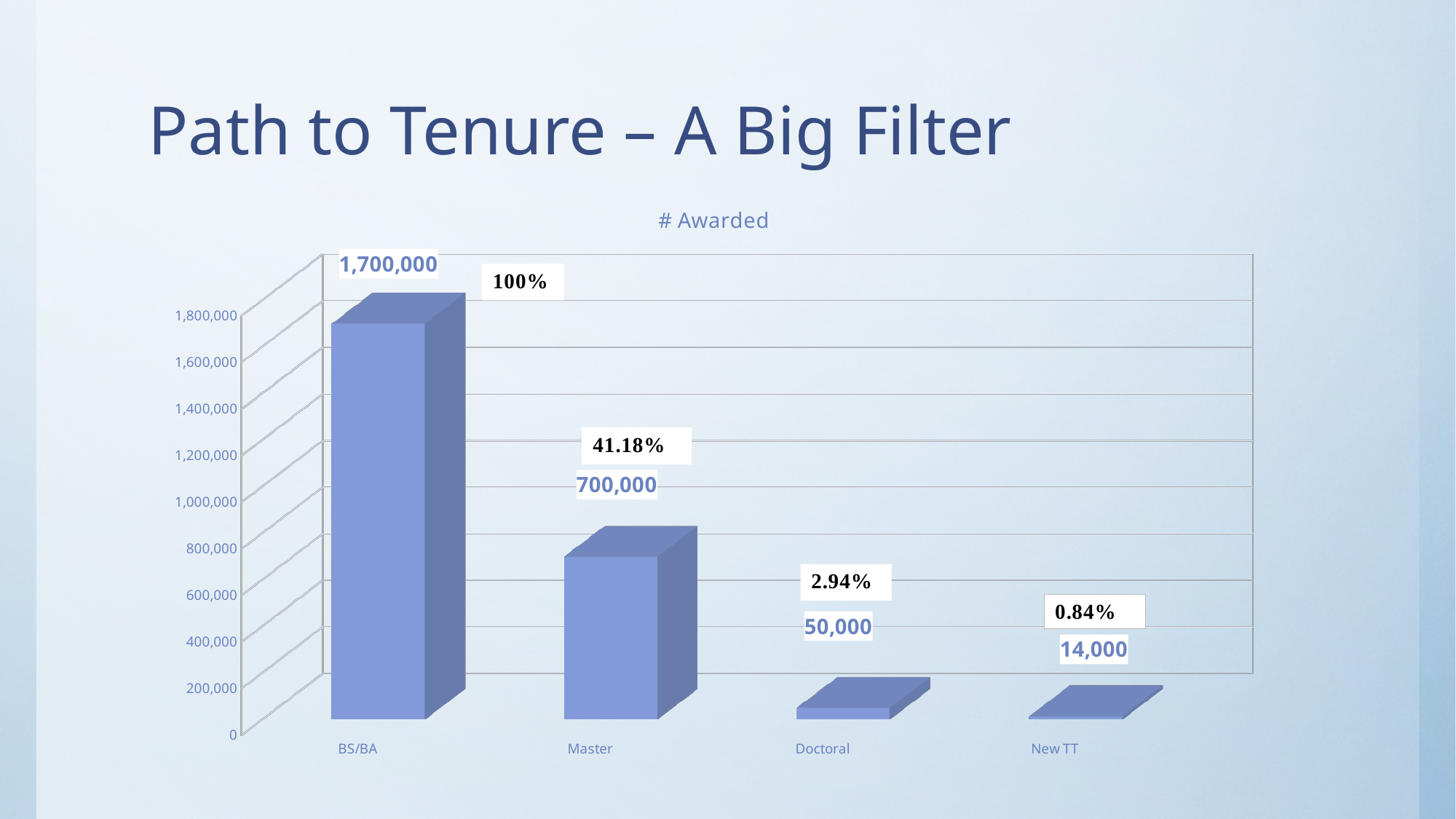
What is the difference between the BS/BA and Master values? 1,000,000 Which category has the highest value in the # Awarded chart? BS/BA What is the value for Doctoral in the # Awarded chart? 50,000 What is the value for New TT in the # Awarded chart? 14,000 What is the value for Master in the # Awarded chart? 700,000 What is the difference between the Doctoral and New TT values? 36,000 How many categories are shown on the x axis of the chart? 4 What percentage label is shown above the Master bar? 41.18% What is the value for BS/BA in the # Awarded chart? 1,700,000 What kind of chart is shown on the slide? Bar chart Which is larger, the value for Master or the value for Doctoral? Master Which category has the lowest value in the # Awarded chart? New TT